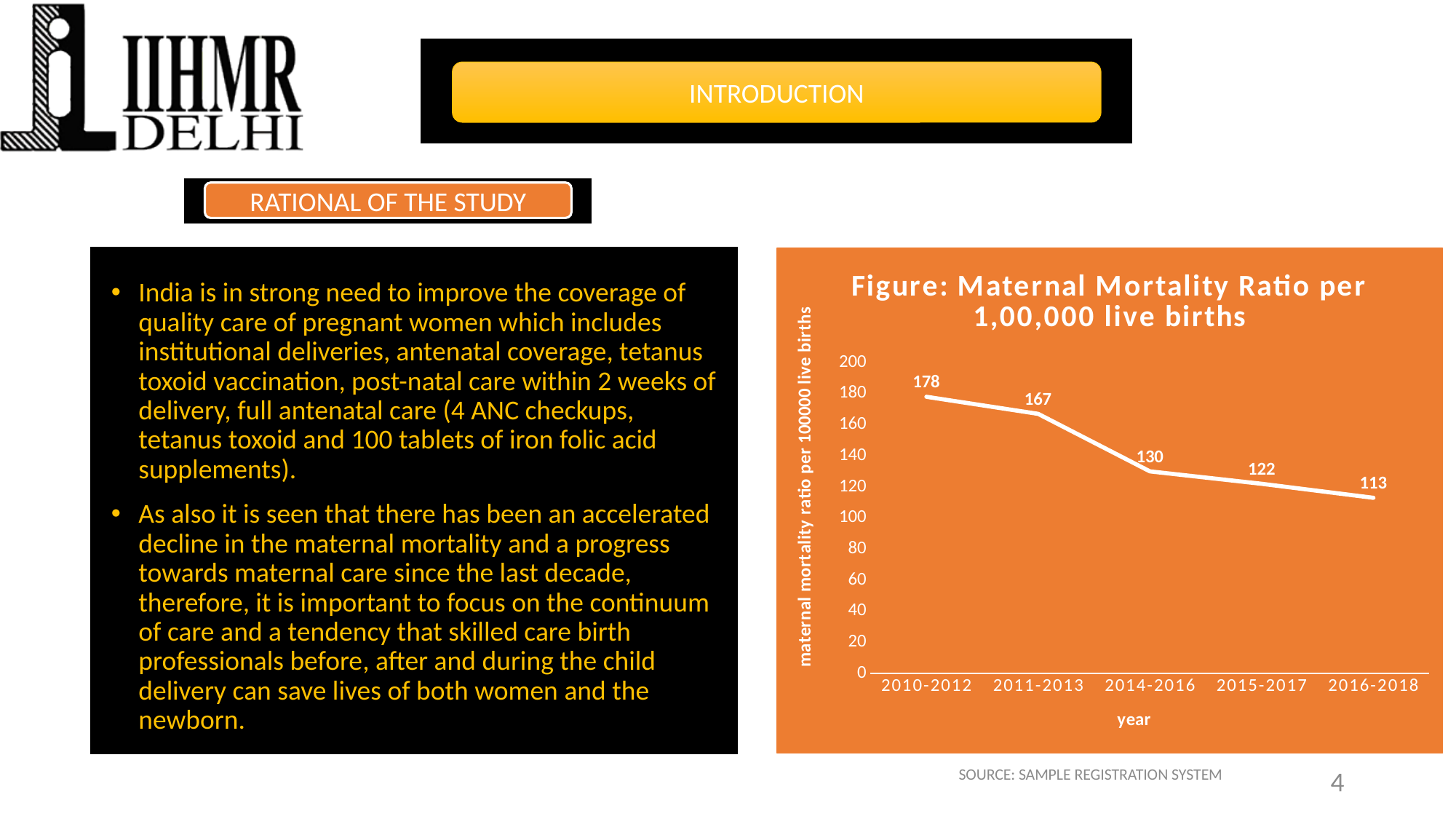
What is the maternal mortality ratio for 2016-2018? 113 How many time periods are plotted on the chart? 5 What is the maternal mortality ratio for 2014-2016? 130 Which period has the lowest maternal mortality ratio? 2016-2018 Do the values rise or fall across the periods from 2010-2012 to 2016-2018? fall Is the value for 2015-2017 greater or less than 140? less Which is larger, the maternal mortality ratio for 2011-2013 or for 2015-2017? 2011-2013 What is the maternal mortality ratio for 2010-2012? 178 What is the difference between the maternal mortality ratio in 2010-2012 and 2016-2018? 65 Which period has the highest maternal mortality ratio? 2010-2012 What is the difference between the maternal mortality ratio in 2011-2013 and 2014-2016? 37 What kind of chart is shown on the slide? line chart